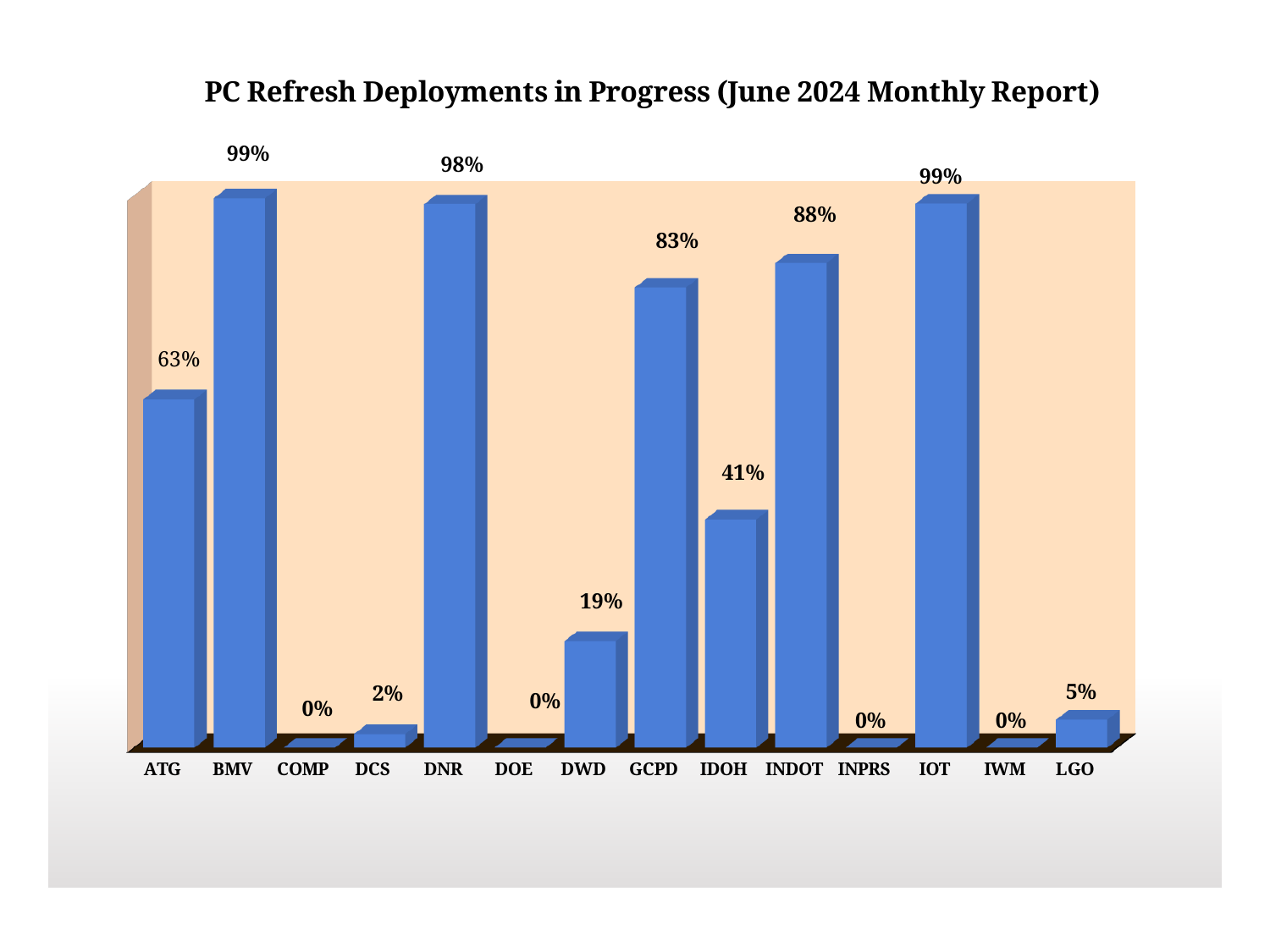
What is the difference between the values for INDOT and IDOH? 47% What is the value for ATG? 63% What is the value for DWD? 19% Which is larger, the value for DCS or the value for LGO? LGO What is the value for LGO? 5% How many categories are shown on the x axis? 14 What kind of chart is shown on the slide? Bar chart What is the value for GCPD? 83% What is the difference between the values for DNR and ATG? 35% What is the value for IDOH? 41% Which is larger, the value for GCPD or the value for INDOT? INDOT What is the title of the chart? PC Refresh Deployments in Progress (June 2024 Monthly Report)